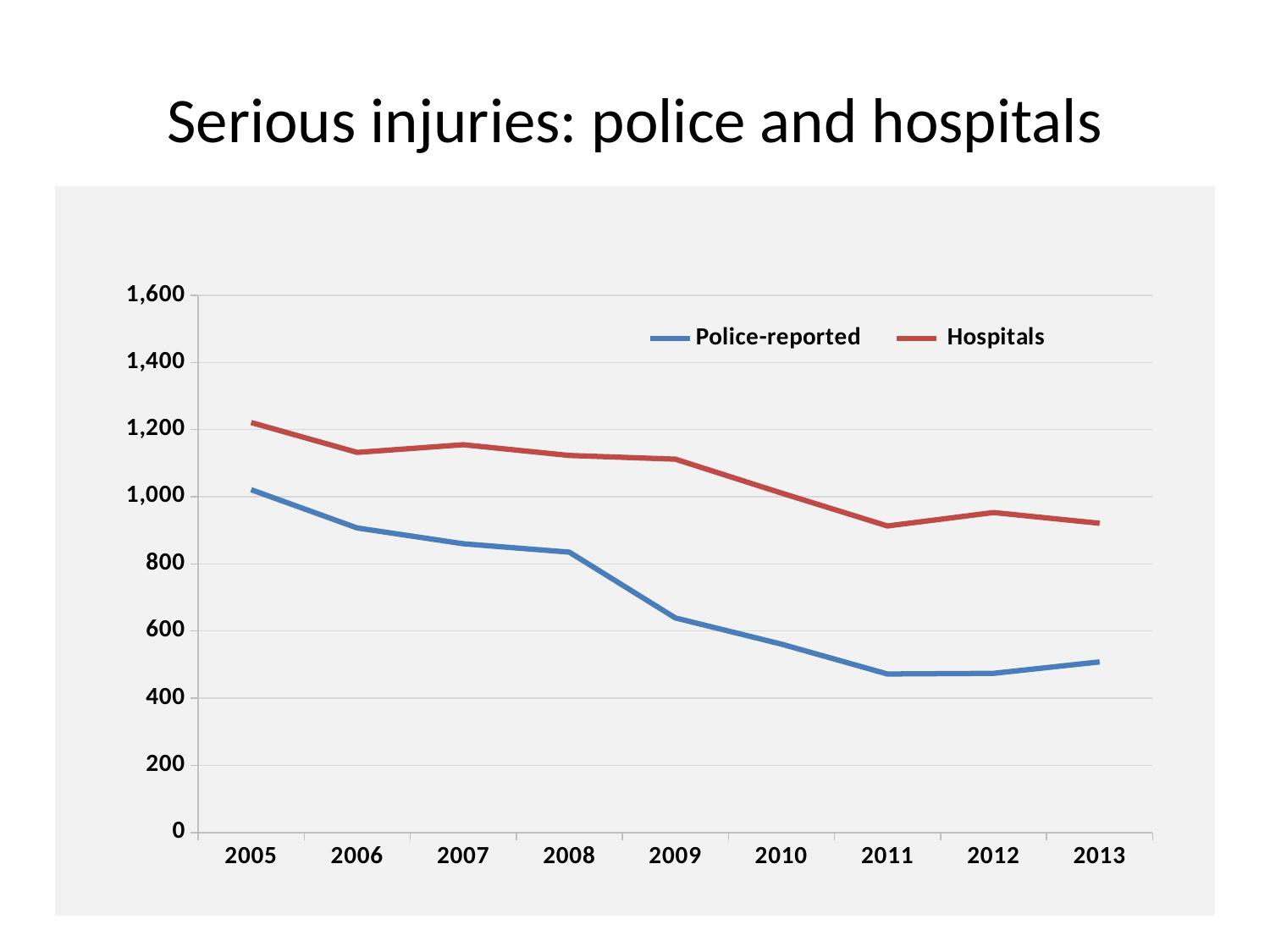
Does the Police-reported series generally rise or fall from 2005 to 2013? fall Which year has the highest value for the Police-reported series? 2005 What kind of chart is shown on the slide? line chart Is the Police-reported value for 2009 greater or less than 800? less What is the title of the chart on the slide? Serious injuries: police and hospitals Is the Hospitals value for 2011 greater or less than 1,000? less In 2009, which series has the larger value, Police-reported or Hospitals? Hospitals Is the Police-reported value for 2011 greater or less than 600? less How many years are plotted along the x axis? 9 How many series does the legend list? 2 Which year has the highest value for the Hospitals series? 2005